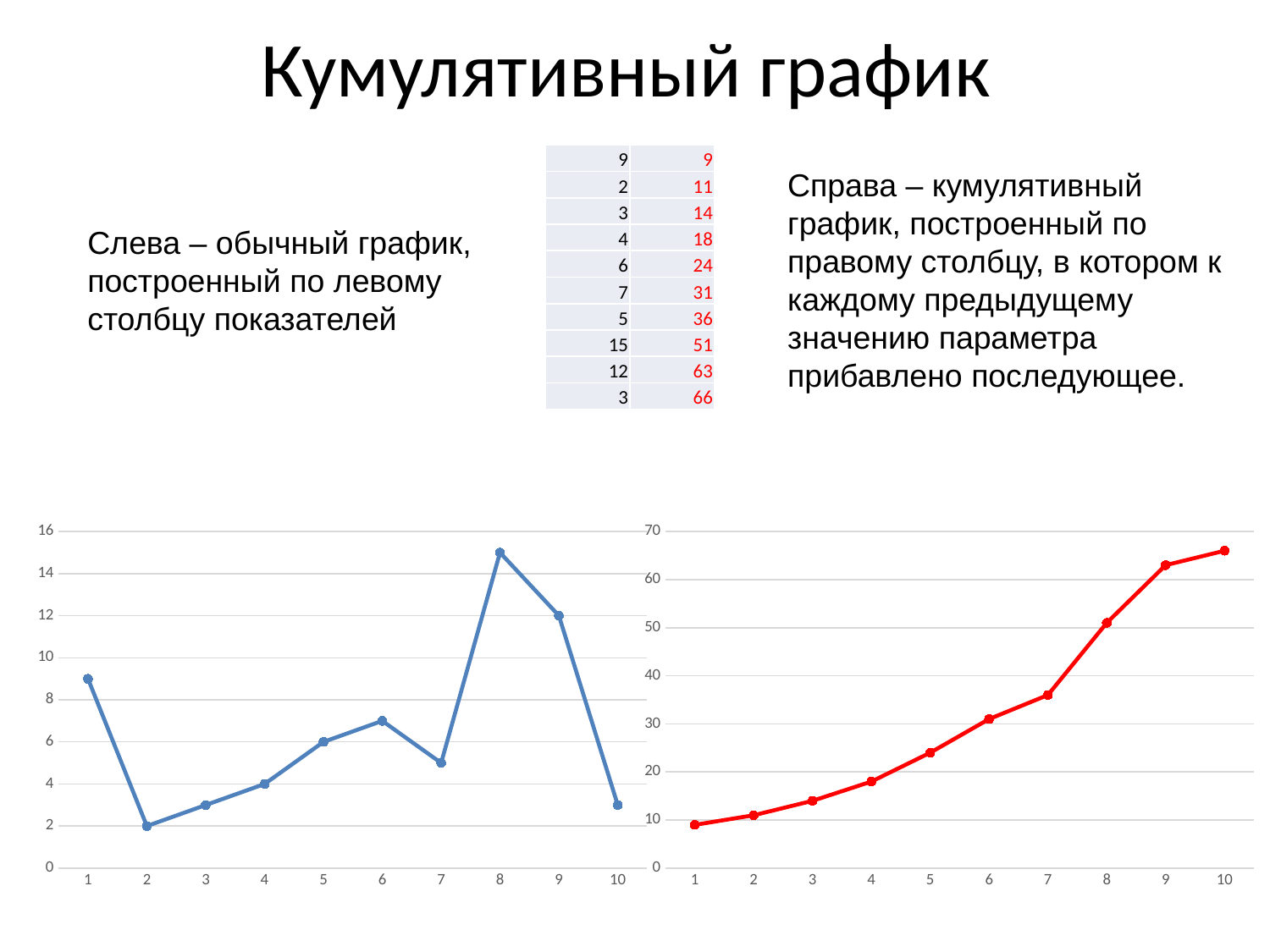
On the right chart, do the values rise or fall along the x axis? rise On the left chart, what is the value at x = 8? 15 On the right chart, is the value at x = 7 greater or less than 40? less How many points are plotted on the right chart? 10 On the left chart, at which x value is the plotted value highest? 8 On the left chart, which is larger: the value at x = 1 or the value at x = 10? x = 1 What kind of chart is the left chart on the slide? line chart On the right chart, what is the value at x = 10? 66 How many points are plotted on the left chart? 10 On the left chart, at which x value is the plotted value lowest? 2 What kind of chart is the right chart on the slide? line chart On the right chart, what is the difference between the value at x = 9 and the value at x = 8? 12